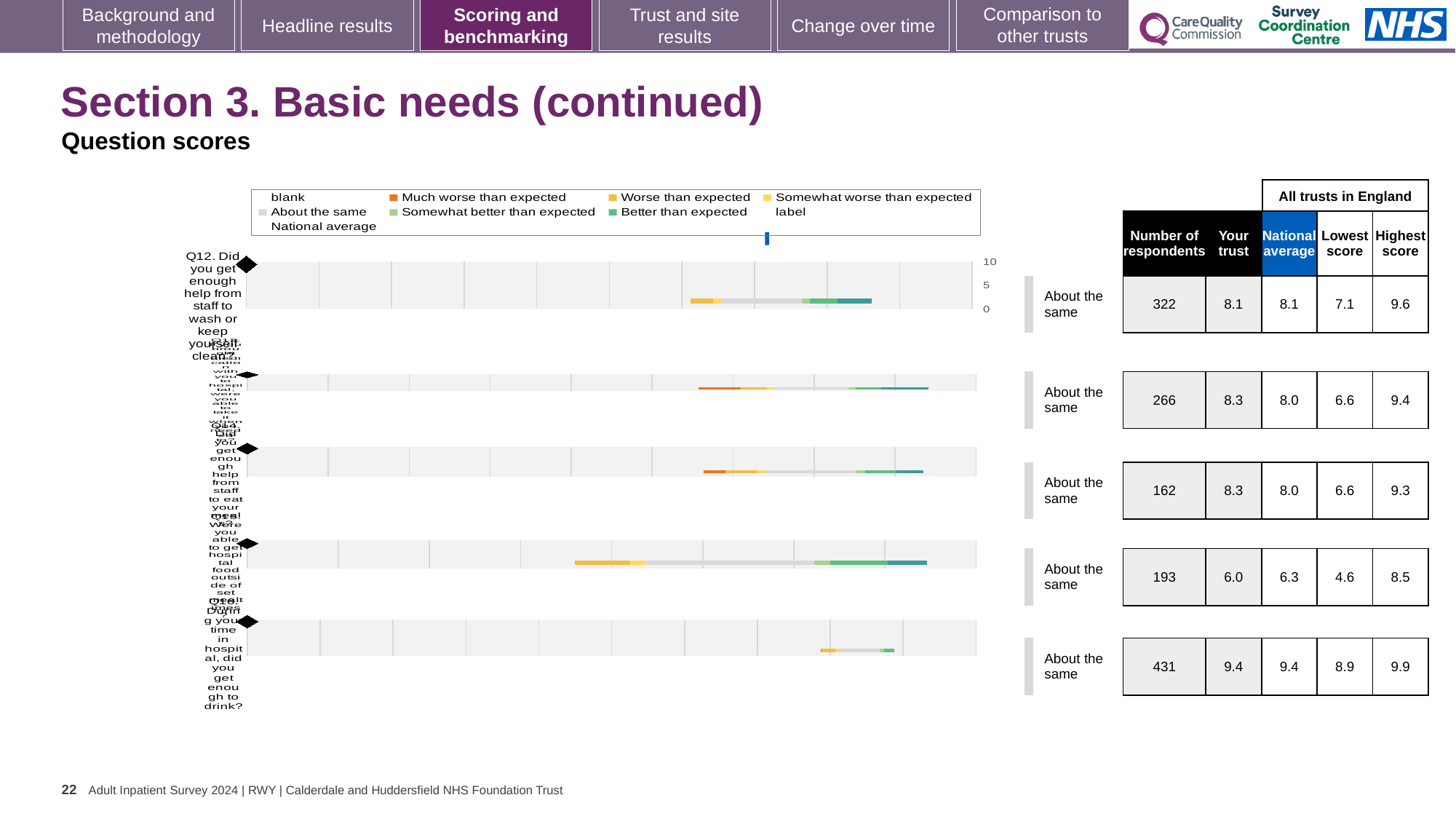
How many question rows are plotted in the chart? 5 What benchmark category is shown next to the Q12 row (help from staff to wash or keep yourself clean)? About the same How many of the question rows are rated 'About the same'? 5 What kind of chart is used to show the question scores on this slide? bar chart What is the lowest score among all trusts in England for Q12 (help from staff to wash or keep yourself clean)? 7.1 What is the highest 'Your trust' score shown in the table on this slide? 9.4 How many respondents are listed for Q12 (help from staff to wash or keep yourself clean)? 322 What is the 'Your trust' score for Q12 (help from staff to wash or keep yourself clean)? 8.1 What is the difference between the highest score (9.6) and the lowest score (7.1) for Q12? 2.5 What is the highest score among all trusts in England for Q12 (help from staff to wash or keep yourself clean)? 9.6 What colour does the legend use for 'Much worse than expected'? orange What is the lowest 'Your trust' score shown in the table on this slide? 6.0